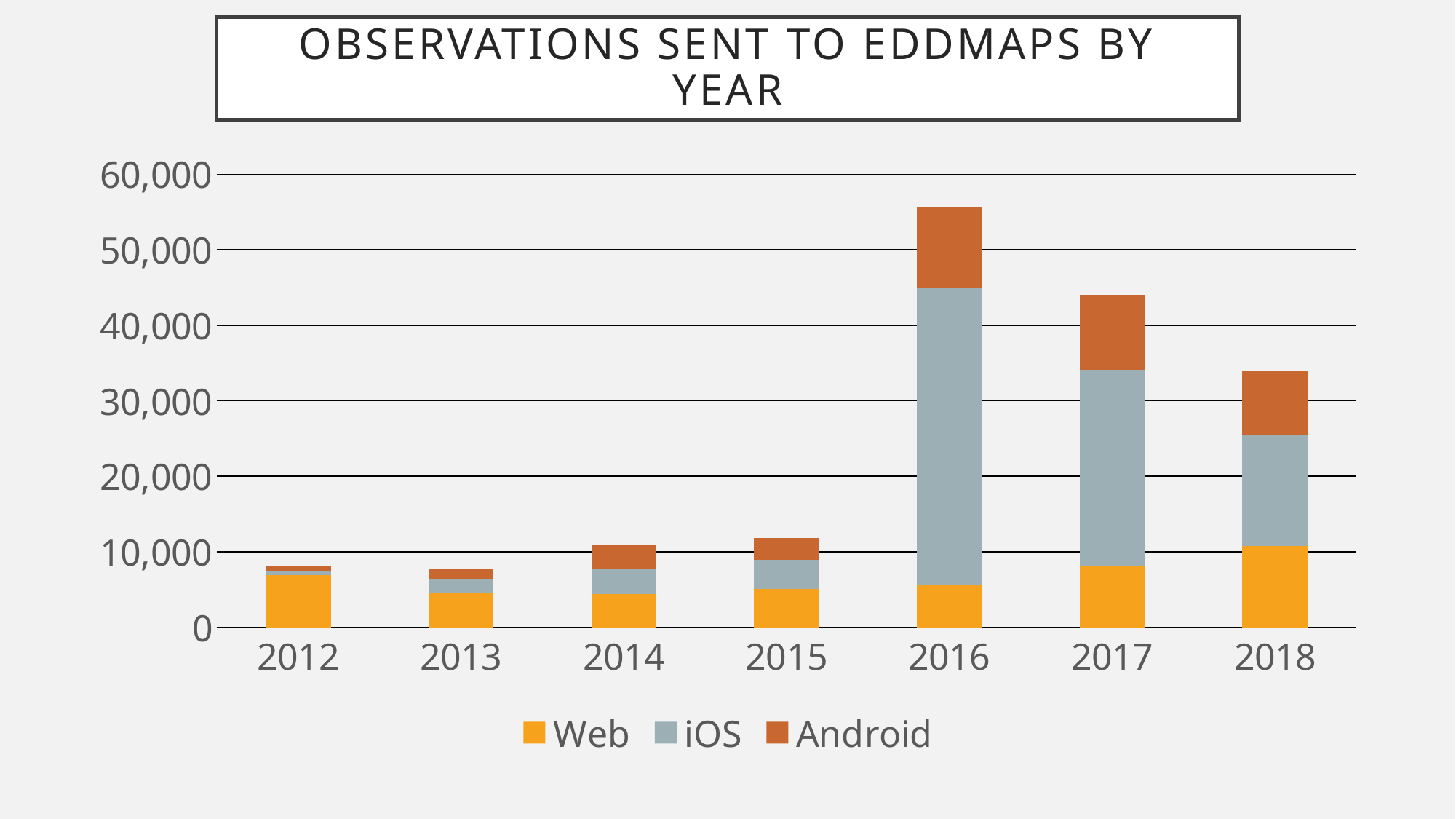
From 2016 to 2018, do the total observations rise or fall? fall What kind of chart is shown on the slide? Stacked bar chart What is the title of the chart? OBSERVATIONS SENT TO EDDMAPS BY YEAR Is the total for 2016 greater or less than 50,000? greater Which colour represents the iOS series in the legend? Grey-blue Which year has the larger total, 2017 or 2018? 2017 Which year has the highest total number of observations? 2016 Is the total for 2017 greater or less than 40,000? greater How many years are shown on the x axis? 7 Is the total for 2018 greater or less than 30,000? greater How many series does the legend list? 3